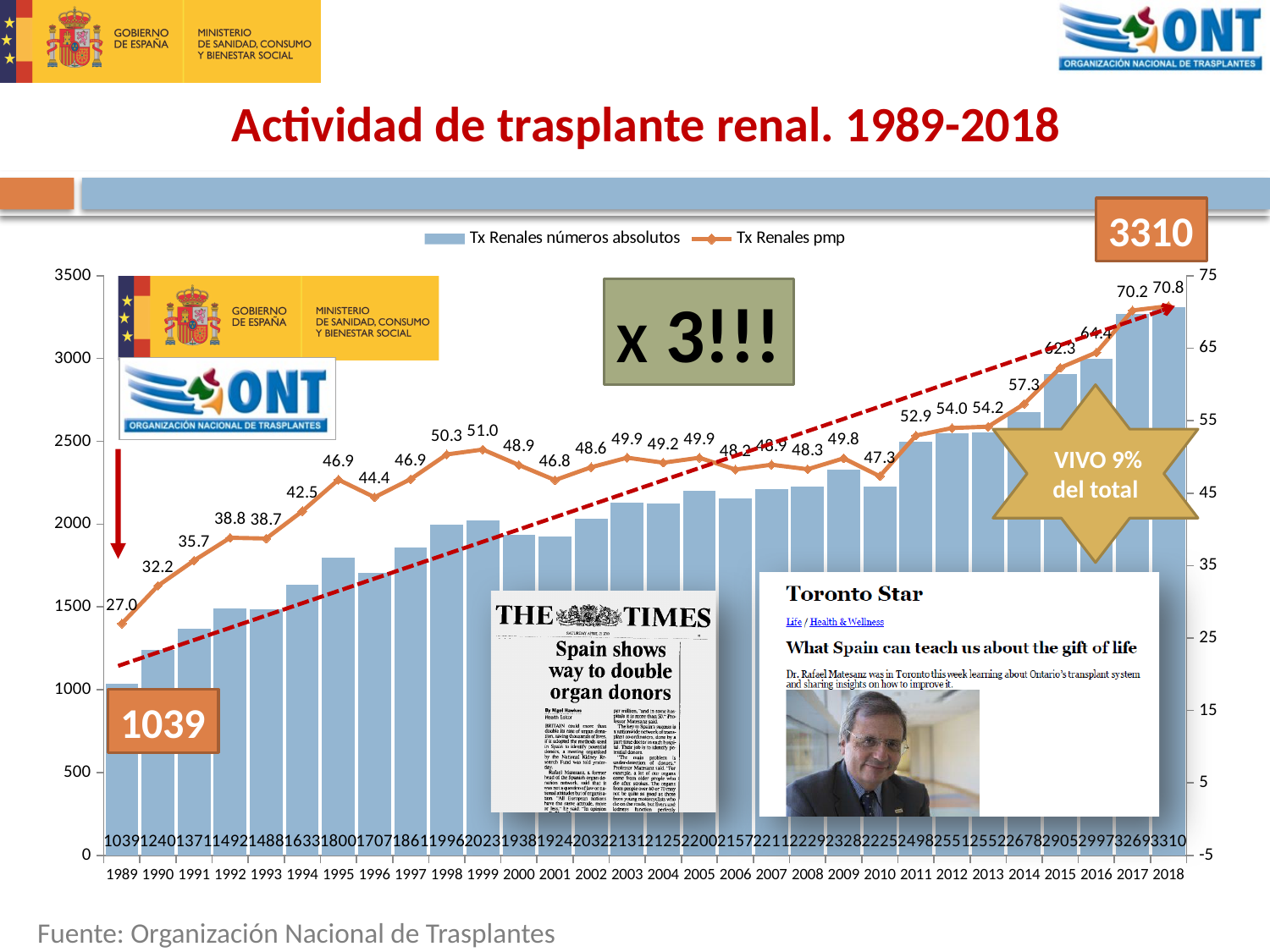
What is the value of Tx Renales pmp for 1989? 27.0 Which year has the lowest value of Tx Renales números absolutos? 1989 What kind of chart is shown on the slide? A combined bar and line chart What is the value of Tx Renales pmp for 2018? 70.8 How many series does the legend list? 2 What is the value of Tx Renales números absolutos for 2018? 3310 How many years are plotted along the x axis? 30 What is the difference between Tx Renales números absolutos in 2018 and in 1989? 2271 Which year has the larger Tx Renales pmp value, 1999 or 2000? 1999 What is the value of Tx Renales números absolutos for 1989? 1039 Which year has the highest value of Tx Renales números absolutos? 2018 What is the value of Tx Renales pmp for 2014? 57.3